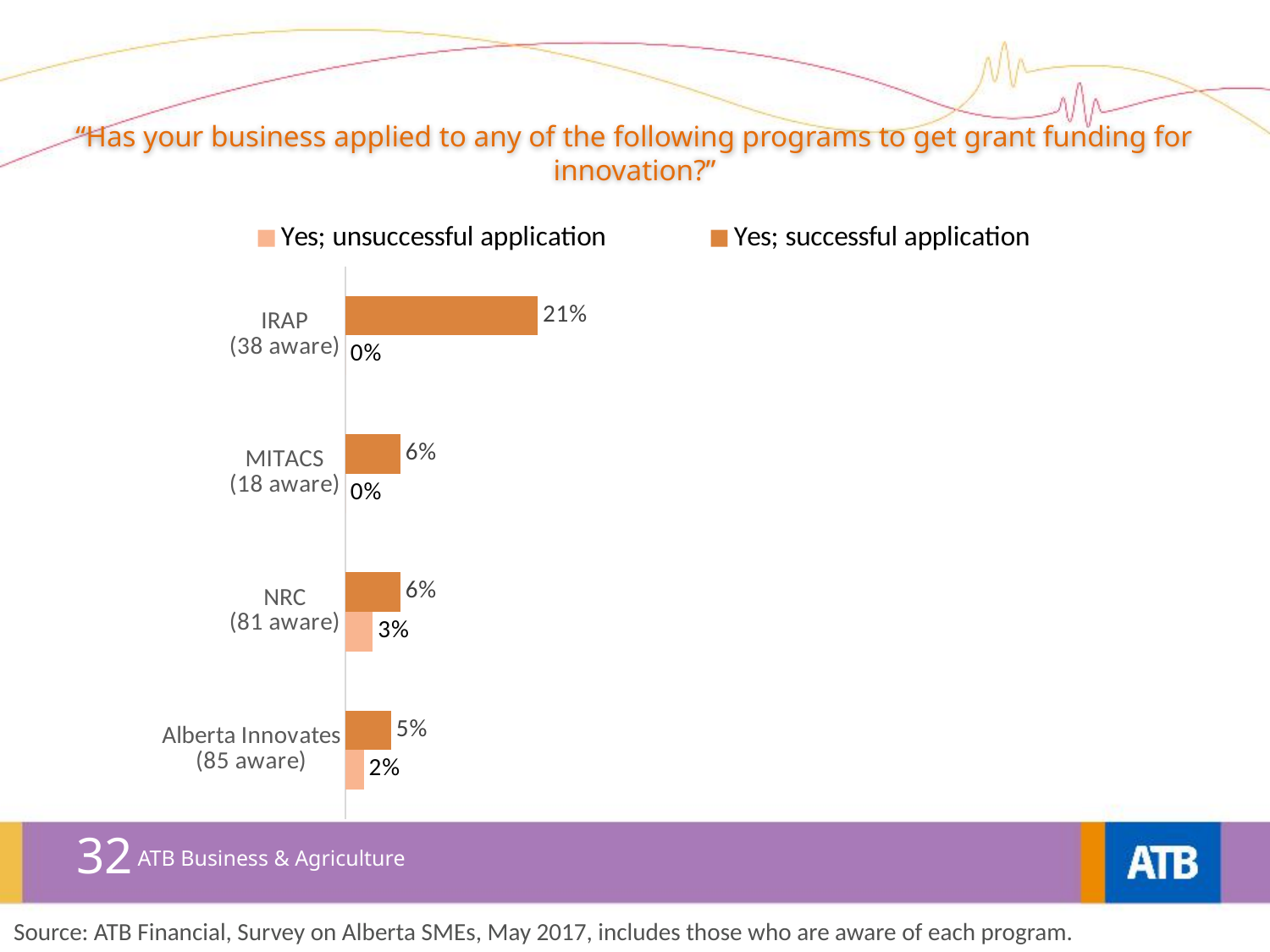
Which program has the lowest share of successful applications? Alberta Innovates What kind of chart is shown on the slide? Bar chart What percentage of businesses aware of IRAP reported a successful application? 21% What percentage of businesses aware of Alberta Innovates reported a successful application? 5% How many series does the legend list? 2 How many programs are shown in the chart? 4 Which is larger: the unsuccessful application rate for NRC or for Alberta Innovates? NRC How many respondents were aware of Alberta Innovates, according to the category label? 85 What percentage of businesses aware of NRC reported an unsuccessful application? 3% What percentage of businesses aware of MITACS reported an unsuccessful application? 0% What is the difference between the successful application rates for IRAP and MITACS? 15% Which program has the highest share of successful applications? IRAP